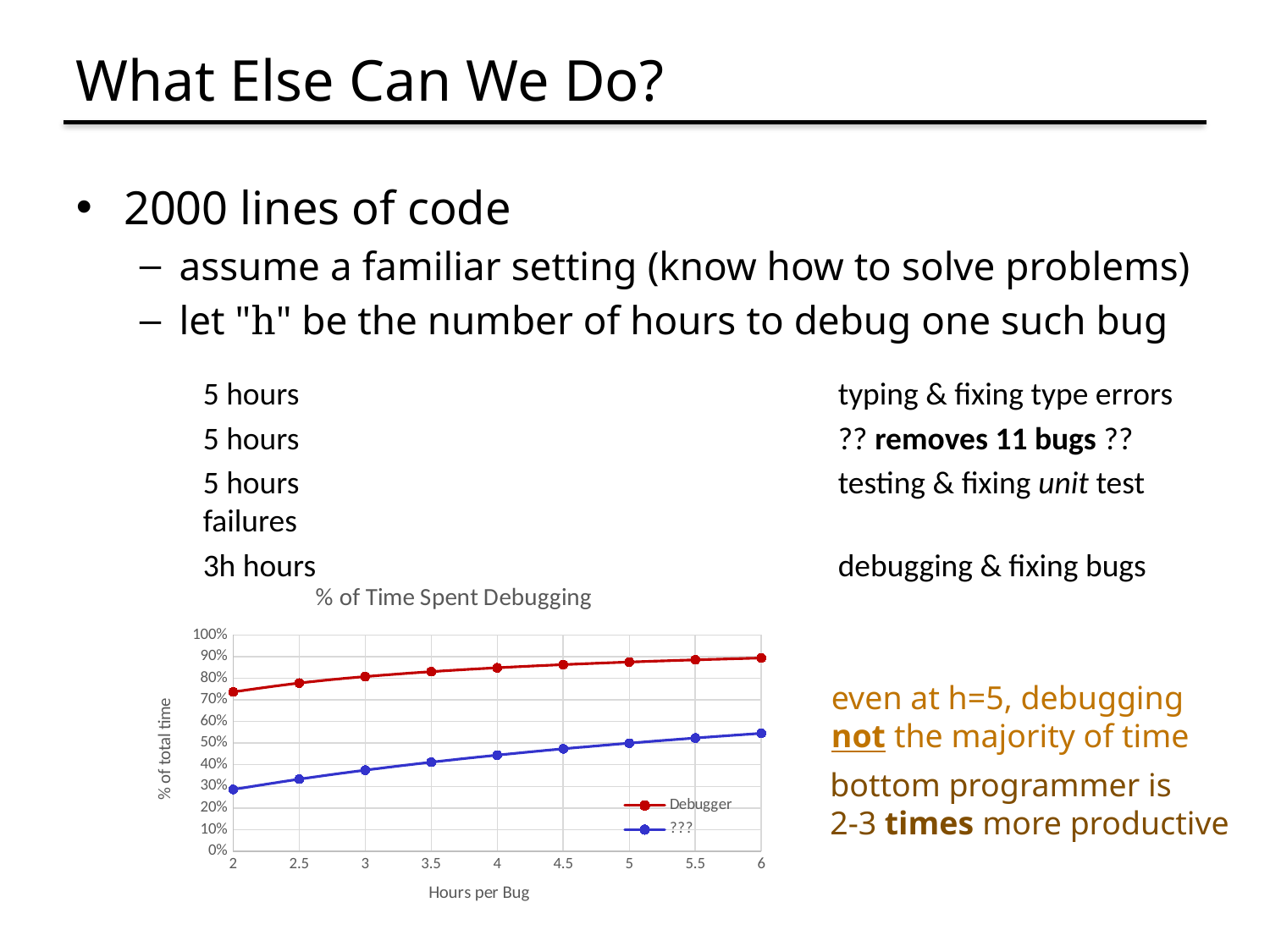
How many data points are plotted for the Debugger series? 9 Is the value for the ??? series at 2 hours per bug greater or less than 40%? less Do the values of the Debugger series rise or fall as Hours per Bug increases? rise At 5 hours per bug, which series has the larger value, Debugger or ??? Debugger What are the two series named in the chart's legend? Debugger and ??? Do the values of the ??? series rise or fall as Hours per Bug increases? rise Is the value for the Debugger series at 6 hours per bug greater or less than 80%? greater Is the value for the ??? series at 4 hours per bug greater or less than 50%? less What is the title of the chart? % of Time Spent Debugging What kind of chart is shown on the slide? line chart How many series does the chart's legend list? 2